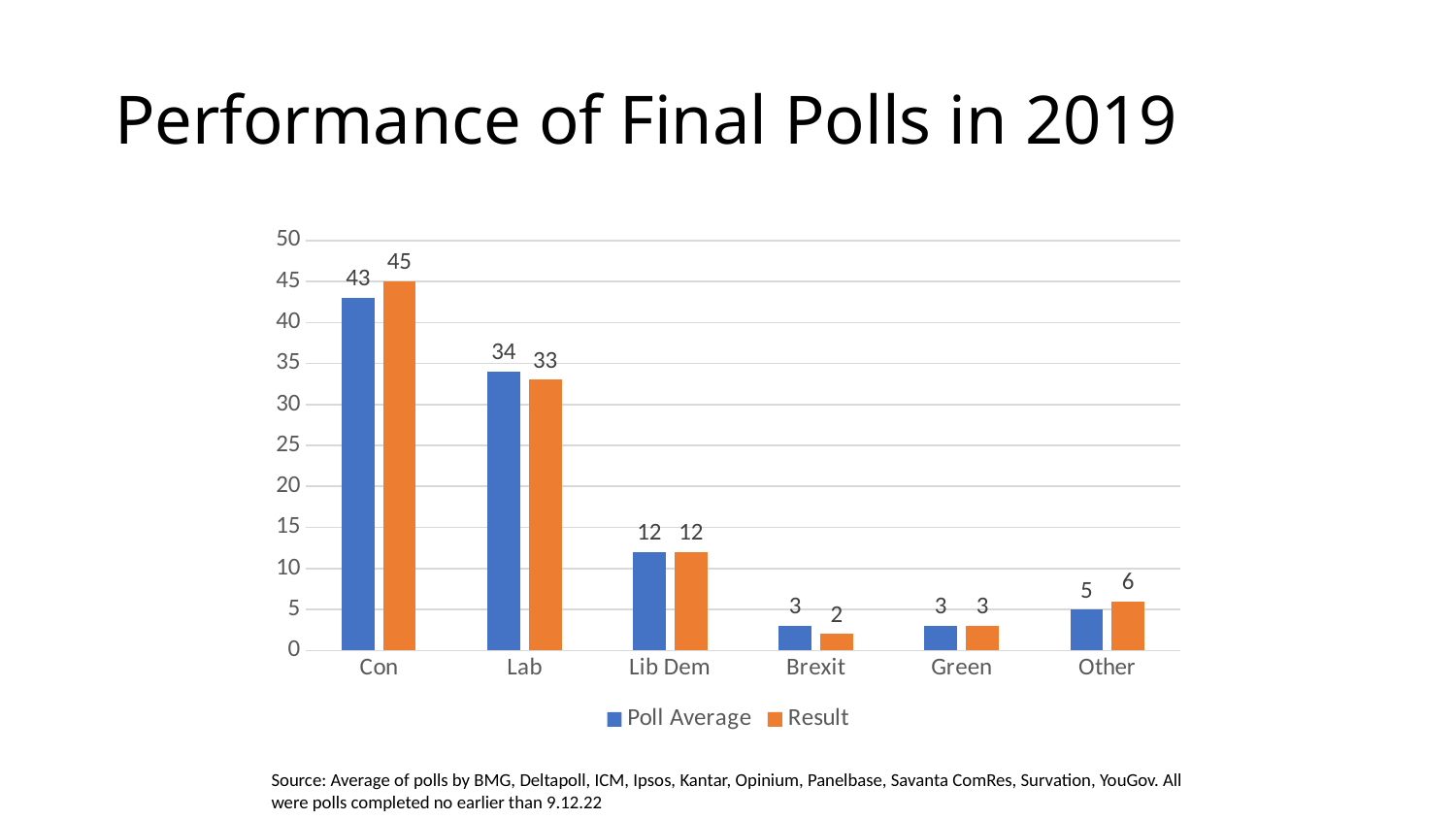
What is the difference between the Result and the Poll Average for Con? 2 How many series does the legend list? 2 How many categories are shown on the x axis? 6 Which is larger for Lab, the Poll Average or the Result? Poll Average Is the Poll Average value for Lib Dem greater or less than 10? greater What is the Result value for Lab? 33 Which category has the highest Result value? Con What is the title of the slide? Performance of Final Polls in 2019 What is the Poll Average value for Con? 43 Which category has the lowest Result value? Brexit What kind of chart is shown on the slide? Bar chart What is the Result value for Other? 6